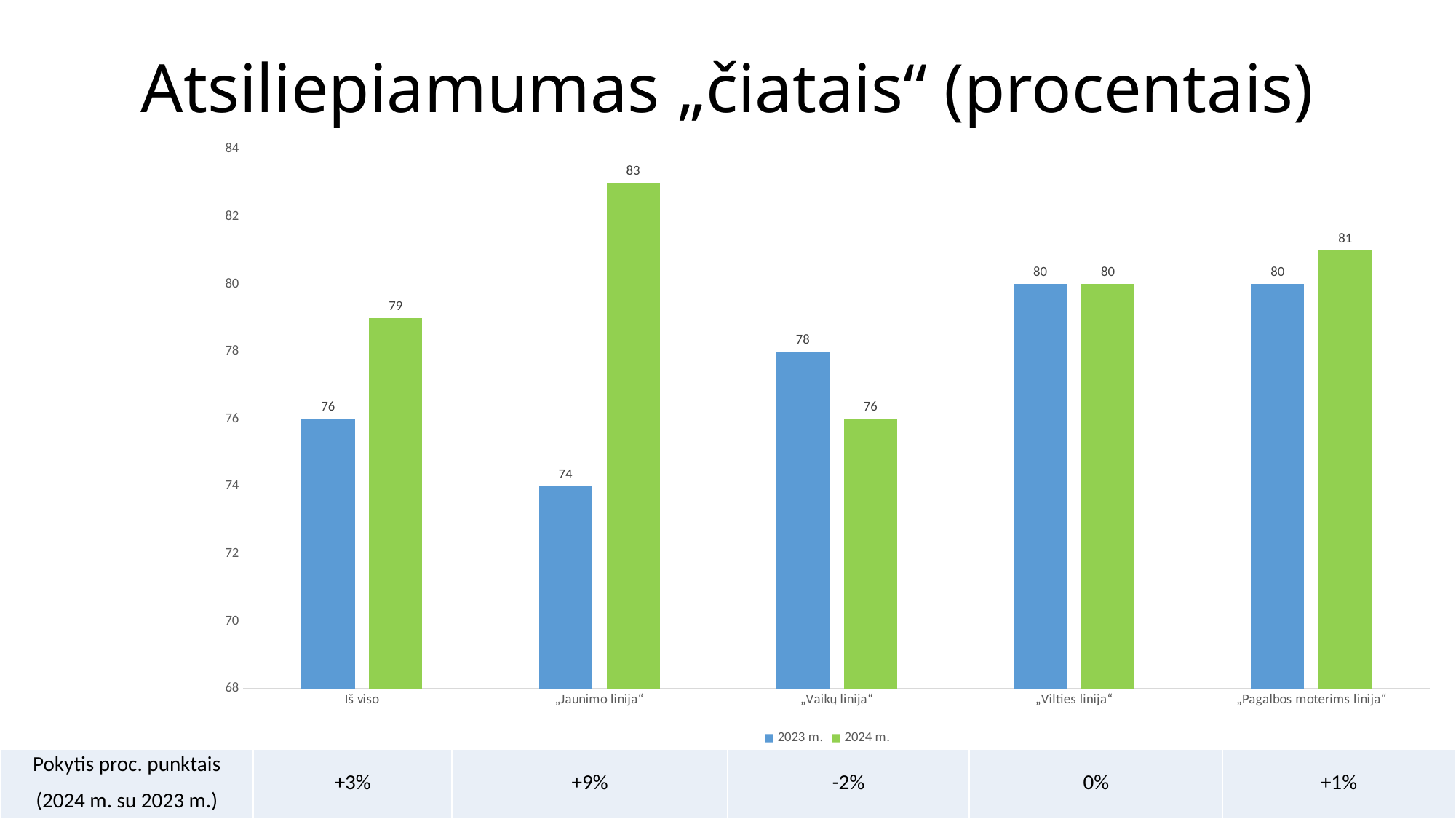
Which is larger for „Vaikų linija“: the 2023 m. value or the 2024 m. value? 2023 m. What kind of chart is shown on the slide? Bar chart What is the 2024 m. value for „Jaunimo linija“? 83 Which category has the lowest 2023 m. value? „Jaunimo linija“ What is the 2024 m. value for Iš viso? 79 How many series does the legend list? 2 Which colour represents the 2024 m. series? Green What is the difference between the 2024 m. and 2023 m. values for „Jaunimo linija“? 9 What is the title of the slide? Atsiliepiamumas „čiatais“ (procentais) How many categories are shown on the x axis? 5 What is the 2023 m. value for „Vaikų linija“? 78 Which category has the highest 2024 m. value? „Jaunimo linija“